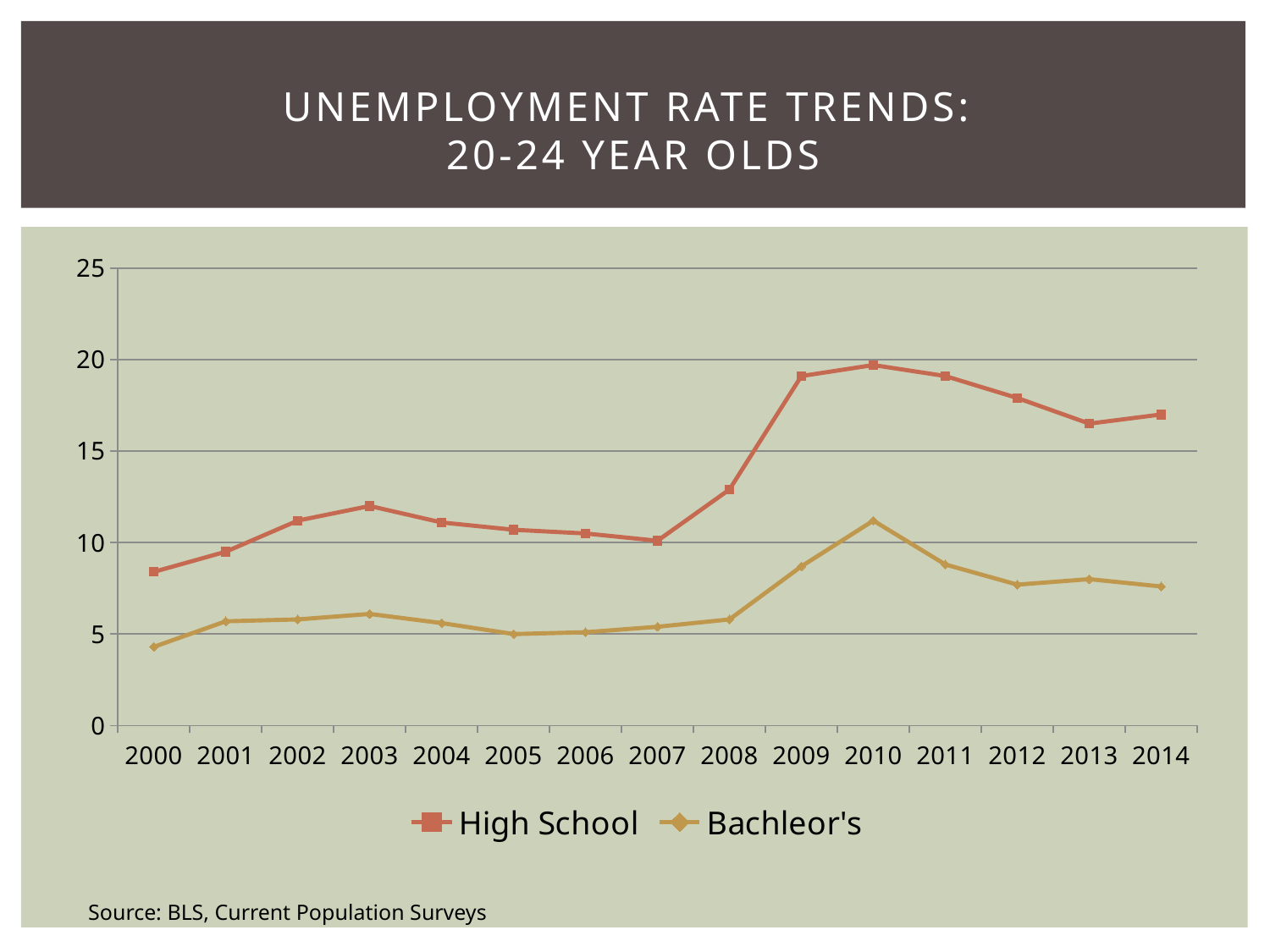
Is the High School value for 2000 greater or less than 10? less In which year does the High School series reach its highest value? 2010 How many series does the legend list? 2 In which year does the Bachleor's series reach its highest value? 2010 Does the High School series rise or fall from 2010 to 2013? fall In which year is the High School series at its lowest value? 2000 Which series has the larger value in 2010, High School or Bachleor's? High School What kind of chart is shown on the slide? line chart Is the High School value for 2009 greater or less than 15? greater Is the Bachleor's value for 2010 greater or less than 10? greater How many years are plotted along the x axis? 15